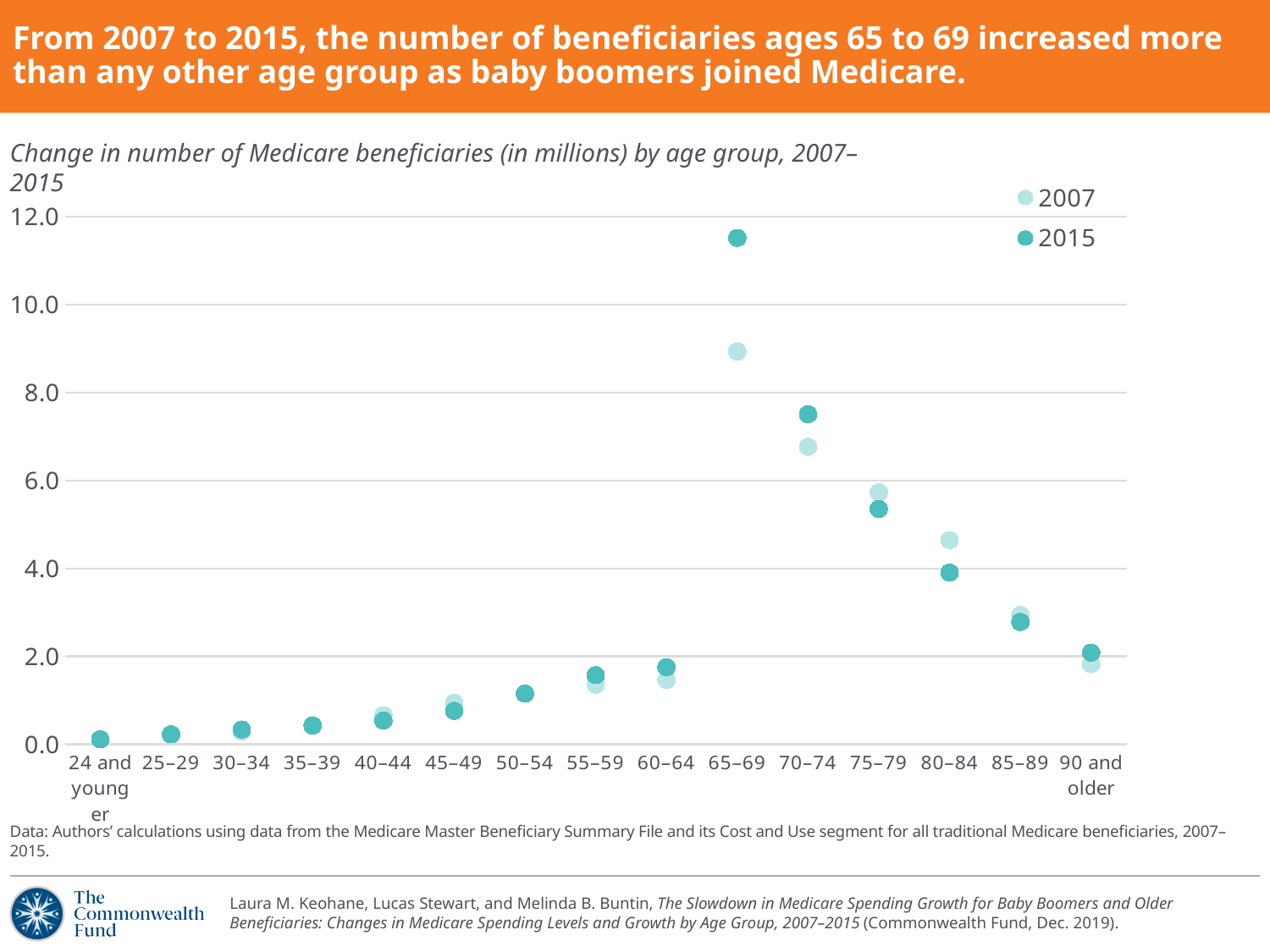
Do the 2015 values rise or fall along the x axis from the 65–69 group to the 90 and older group? fall Which age group has the highest 2015 value? 65–69 For the 70–74 age group, which series has the larger value, 2007 or 2015? 2015 Is the 2007 value for the 80–84 age group greater or less than 4.0? greater Which age group has the highest 2007 value? 65–69 What kind of chart is shown on the slide? scatter chart How many age groups are plotted along the x axis? 15 Is the 2015 value for the 65–69 age group greater or less than 10.0? greater What are the two entries listed in the chart legend? 2007 and 2015 How many series does the legend list? 2 For the 80–84 age group, which series has the larger value, 2007 or 2015? 2007 Is the 2007 value for the 65–69 age group greater or less than 10.0? less